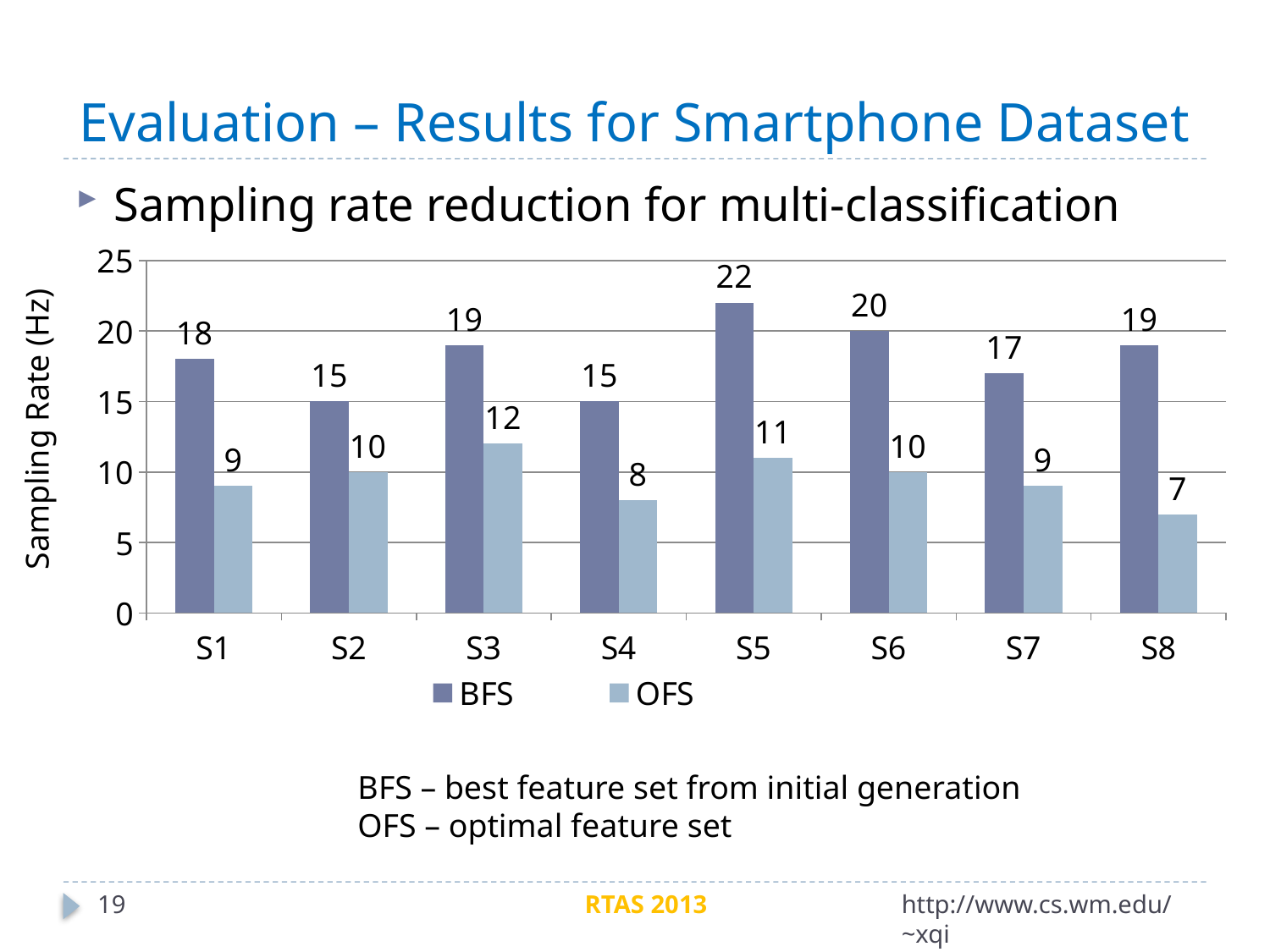
Which subject has the lowest OFS sampling rate? S8 What is the difference between the BFS sampling rates for S5 and S2? 7 What is the OFS sampling rate for S3? 12 What is the label of the y axis? Sampling Rate (Hz) What is the BFS sampling rate for S5? 22 Which is larger, the OFS sampling rate for S3 or for S6? S3 What kind of chart is shown on the slide? Bar chart Which subject has the highest BFS sampling rate? S5 How many series does the legend list? 2 What is the OFS sampling rate for S4? 8 How many subjects are shown on the x axis? 8 What is the difference between the BFS and OFS sampling rates for S1? 9